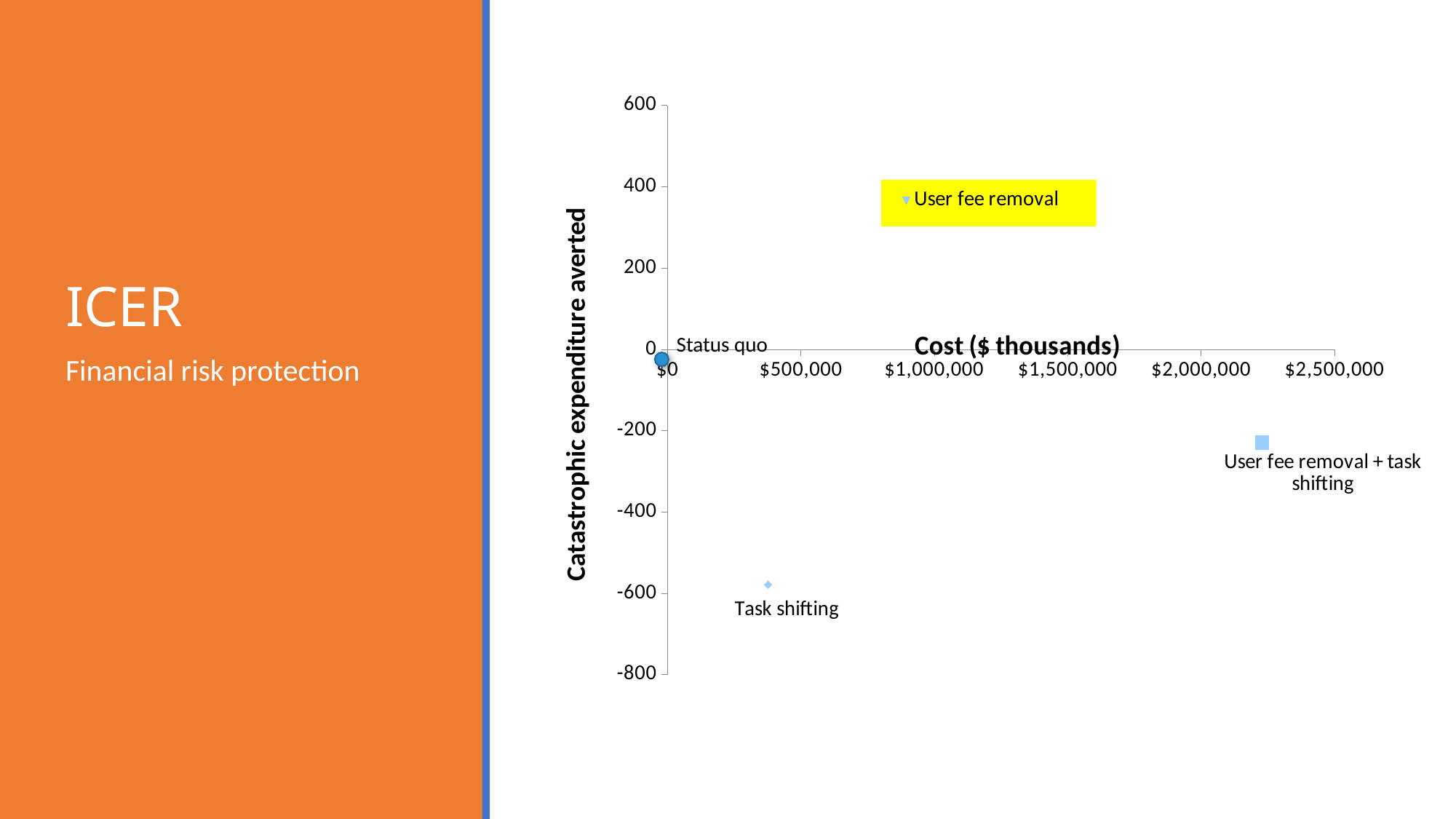
Which strategy has the lowest catastrophic expenditure averted? Task shifting What kind of chart is shown on the slide? scatter chart How many data points are plotted on the chart? 4 Is the catastrophic expenditure averted for Task shifting greater or less than -400? less Is the catastrophic expenditure averted for User fee removal greater or less than 200? greater What is the cost of the Status quo point? $0 What is the title of the vertical axis? Catastrophic expenditure averted Which strategy has the highest catastrophic expenditure averted? User fee removal Which has the higher catastrophic expenditure averted, User fee removal or User fee removal + task shifting? User fee removal Which strategy has the highest cost? User fee removal + task shifting Which point is highlighted with a yellow label box? User fee removal Is the cost for User fee removal + task shifting greater or less than $2,000,000? greater